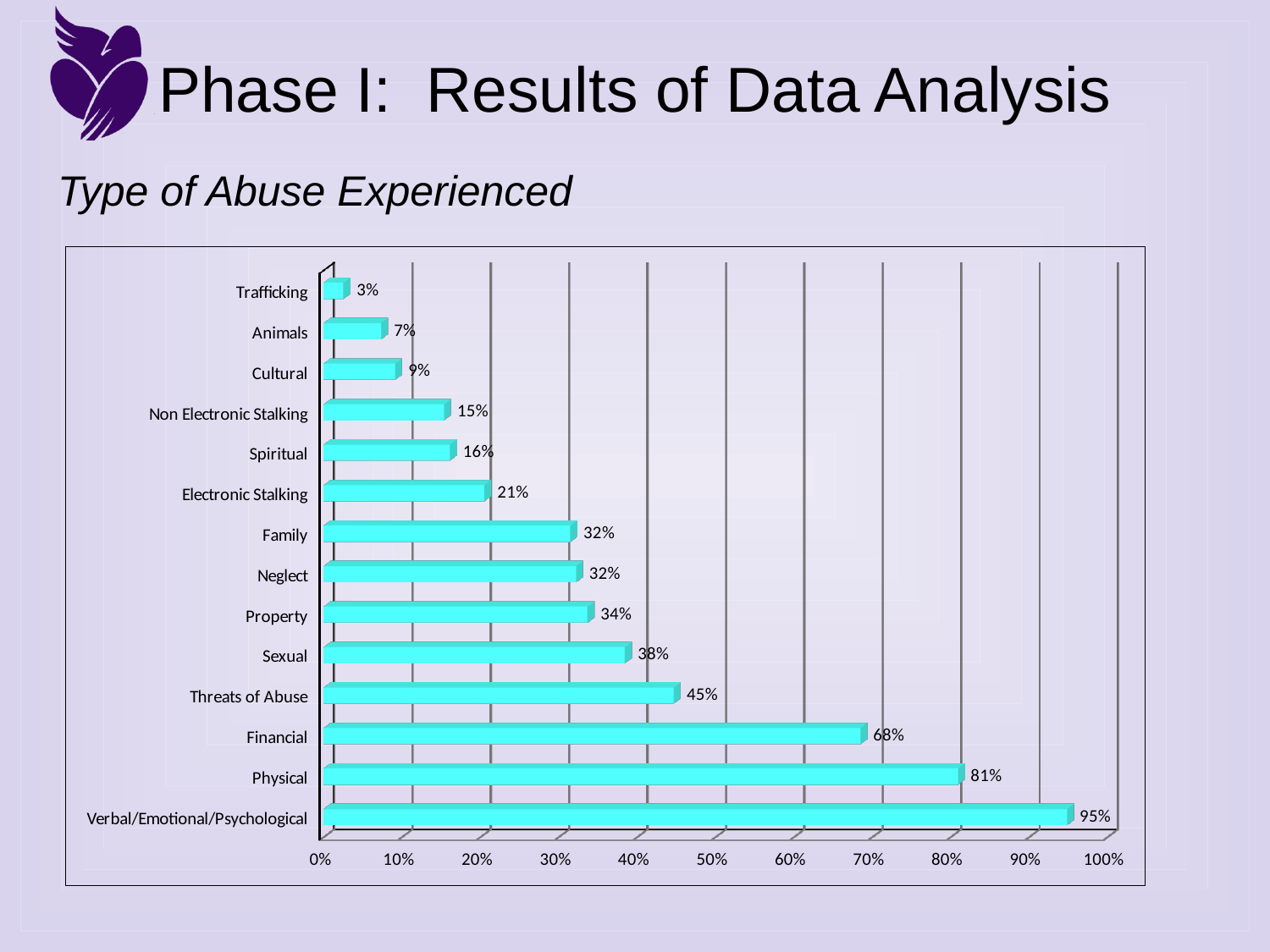
Is the value for Threats of Abuse greater or less than 50%? less Which is larger, the percentage for Sexual abuse or for Property abuse? Sexual What percentage is shown for Trafficking? 3% Which type of abuse has the highest percentage? Verbal/Emotional/Psychological What percentage is shown for Electronic Stalking? 21% What percentage is shown for Financial abuse? 68% What kind of chart is shown on the slide? bar chart Which type of abuse has the lowest percentage? Trafficking What is the difference between the percentages for Spiritual abuse and Non Electronic Stalking? 1% What is the title of the chart on the slide? Type of Abuse Experienced How many types of abuse are shown in the chart? 14 What is the difference between the percentages for Physical and Financial abuse? 13%